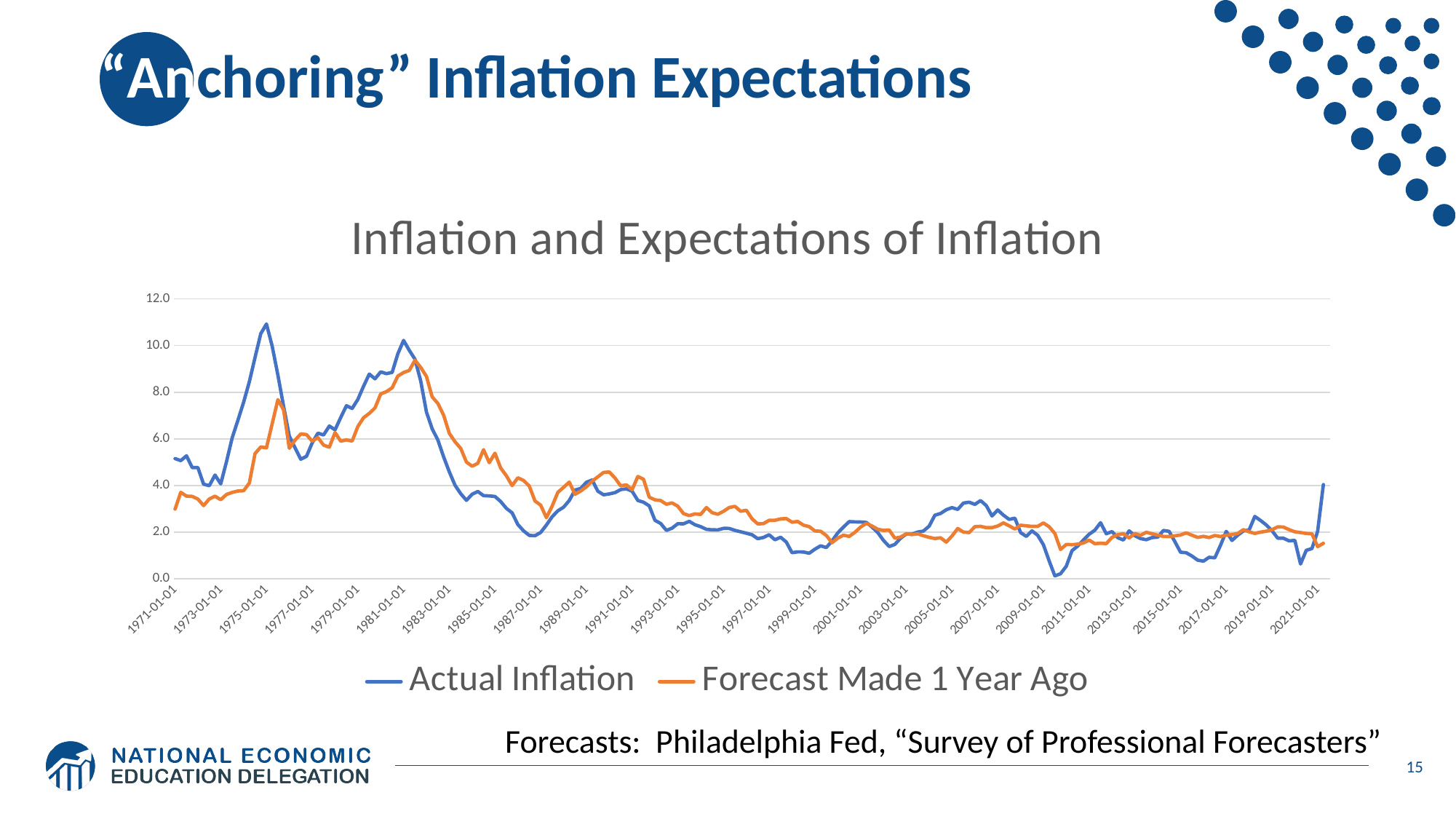
Is the peak value of Forecast Made 1 Year Ago around 1982 greater or less than 8.0? greater Does Actual Inflation generally rise or fall between 1973 and 1975? rise What is the title of the chart? Inflation and Expectations of Inflation Around 1975, which series reaches the higher value, Actual Inflation or Forecast Made 1 Year Ago? Actual Inflation What kind of chart is shown on the slide? Line chart Which series is drawn in orange? Forecast Made 1 Year Ago Is the peak value of Actual Inflation around 1975 greater or less than 10.0? greater Around 1987, which series is higher, Actual Inflation or Forecast Made 1 Year Ago? Forecast Made 1 Year Ago Is the peak value of Forecast Made 1 Year Ago around 1975 greater or less than 8.0? less Does Actual Inflation generally rise or fall between 1981 and 1987? fall How many series does the legend list? 2